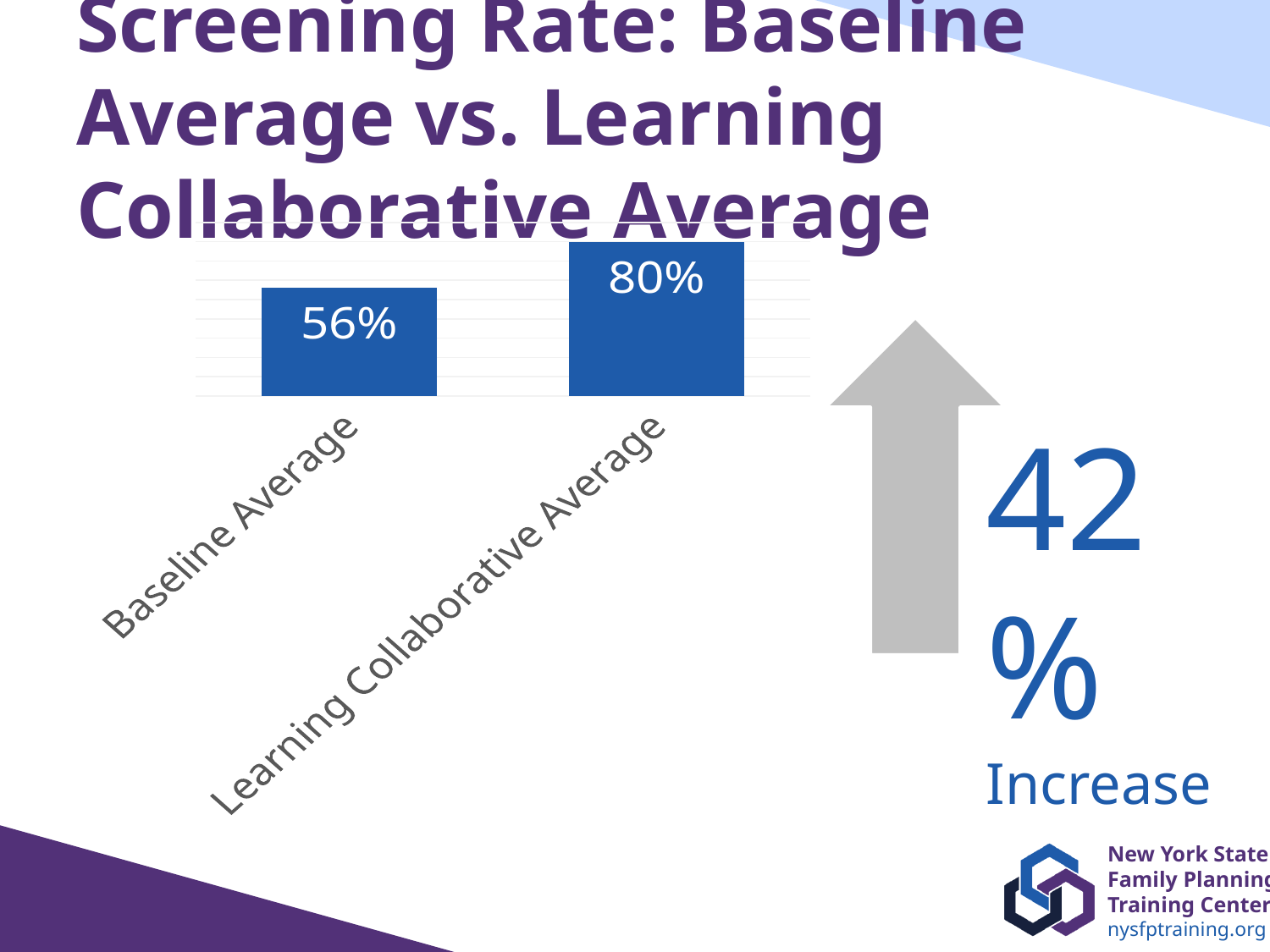
What kind of chart is shown on the slide? Bar chart What colour are the bars in the chart? Blue Do the values rise or fall from Baseline Average to Learning Collaborative Average? Rise How many categories are shown in the chart? 2 What is the value for Baseline Average? 56% Which is larger, the Baseline Average or the Learning Collaborative Average? Learning Collaborative Average What percentage increase is stated next to the arrow on the slide? 42% Which category has the lowest value? Baseline Average What is the value for Learning Collaborative Average? 80% What is the difference between the Learning Collaborative Average and the Baseline Average? 24% Which category has the highest value? Learning Collaborative Average